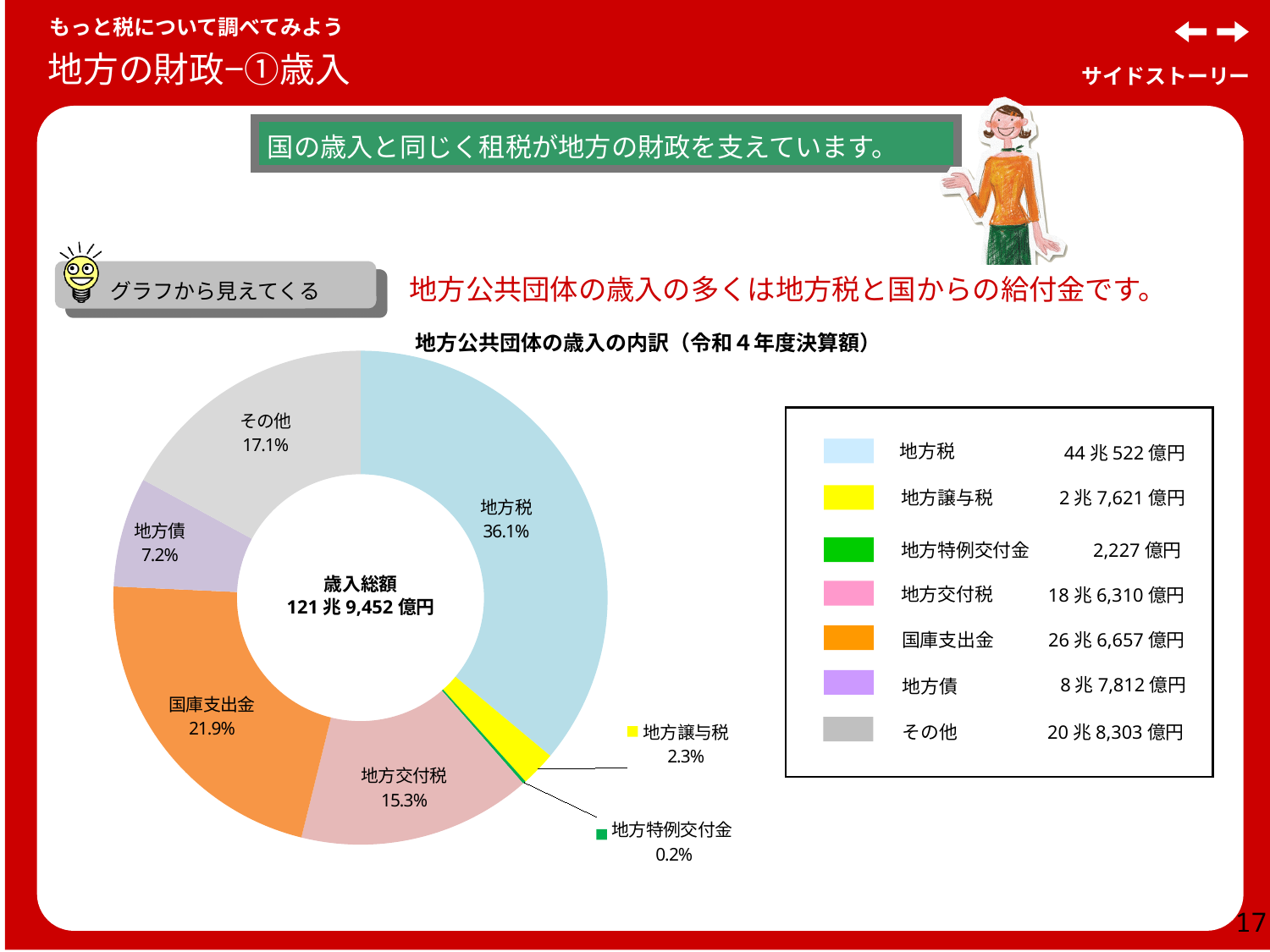
Which category has the smallest share in the chart? 地方特例交付金 What is the share of 地方交付税 in the chart? 15.3% What is the difference in percentage points between 国庫支出金 and 地方交付税? 6.6 percentage points Which category has the largest share of local government revenue? 地方税 Which is larger, the share of その他 or the share of 地方債? その他 According to the legend table, what is the amount for 地方交付税? 18兆6,310億円 How many categories are shown in the chart? 7 What percentage of the revenue is 国庫支出金? 21.9% What share of local government revenue does 地方税 account for? 36.1% What kind of chart is used to show the breakdown of local government revenue? Donut (pie) chart What percentage does 地方特例交付金 represent? 0.2% What is the total revenue (歳入総額) shown in the centre of the chart? 121兆9,452億円